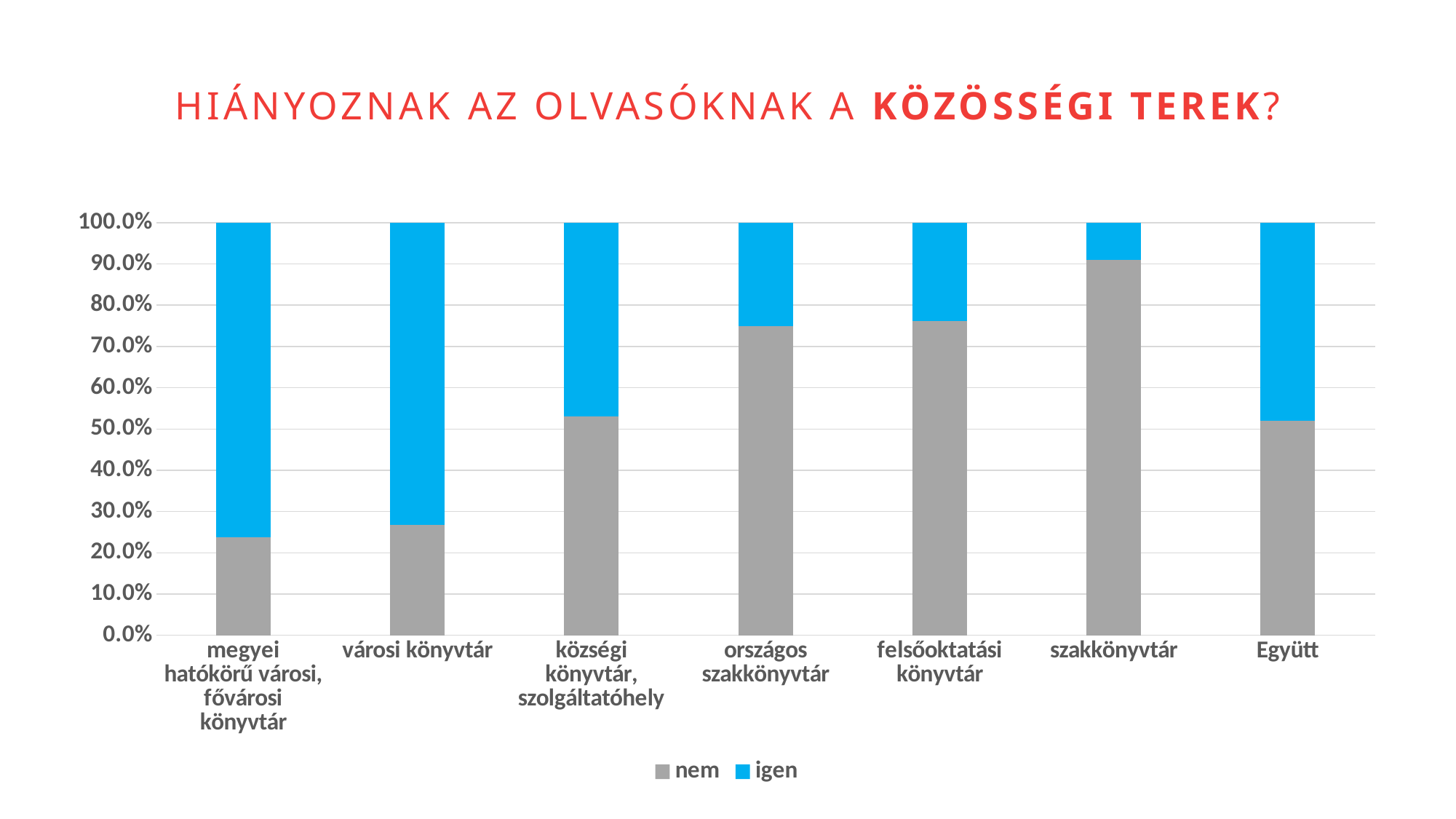
How many categories are shown on the x axis of the chart? 7 What kind of chart is shown on the slide? stacked bar chart Is the 'nem' share for Együtt greater or less than 60%? less Is the 'nem' share for országos szakkönyvtár greater or less than 70%? greater Is the 'nem' share for városi könyvtár greater or less than 30%? less Which category has the largest 'igen' share? megyei hatókörű városi, fővárosi könyvtár Which has a larger 'nem' share: községi könyvtár, szolgáltatóhely or országos szakkönyvtár? országos szakkönyvtár Which category has the largest 'nem' share? szakkönyvtár Which category has the smallest 'igen' share? szakkönyvtár What colour represents the 'igen' series in the chart? blue How many series does the legend list? 2